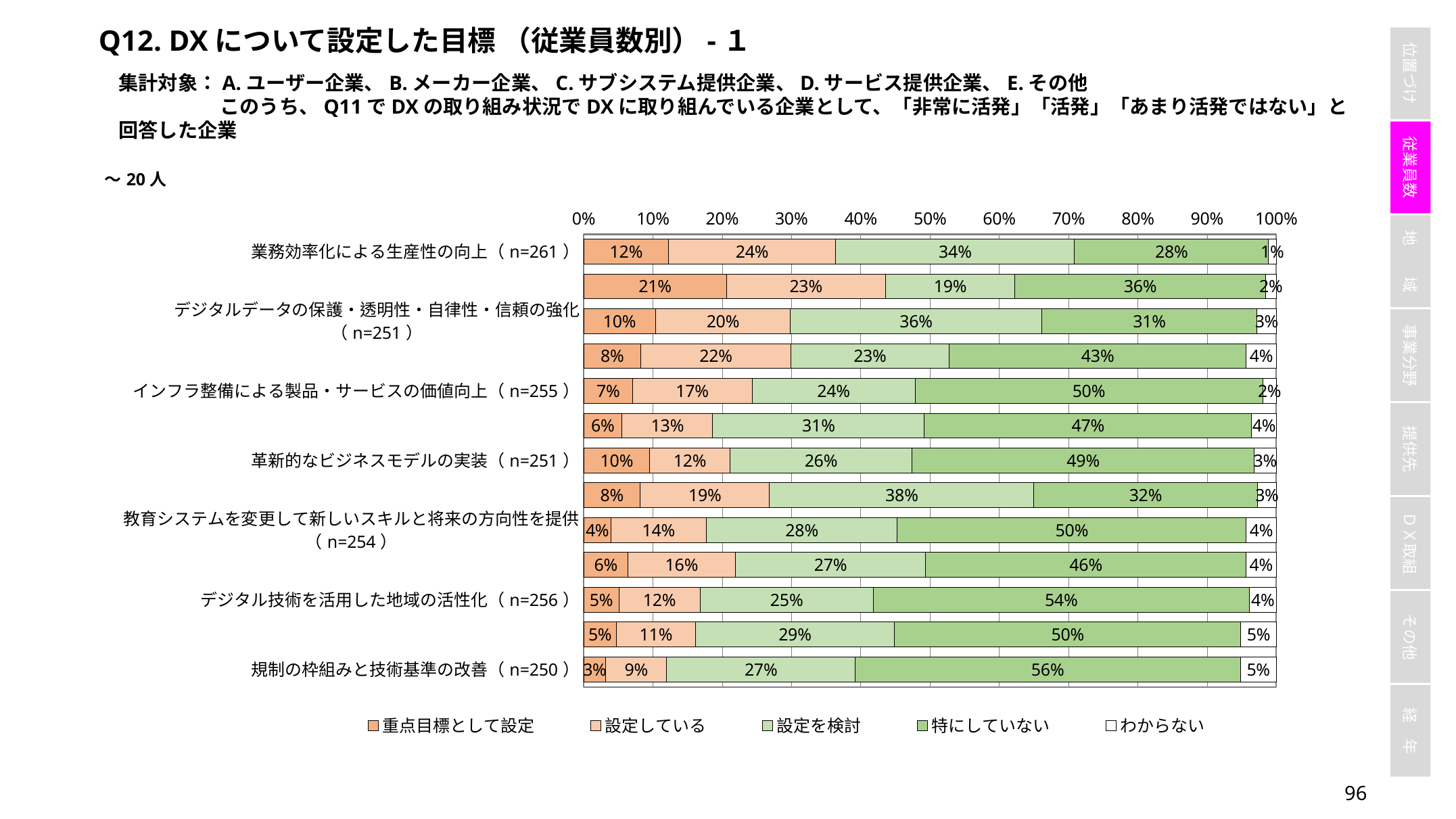
How many series does the legend list? 5 What is the わからない value for デジタル技術を活用した地域の活性化? 4% What is the first entry in the chart legend? 重点目標として設定 Which response category is the largest segment in the bar for 規制の枠組みと技術基準の改善? 特にしていない Which has a larger 特にしていない share: 業務効率化による生産性の向上 or 規制の枠組みと技術基準の改善? 規制の枠組みと技術基準の改善 What is the 設定を検討 value for インフラ整備による製品・サービスの価値向上? 24% What kind of chart is shown on the slide? Stacked bar chart What is the 設定を検討 value for デジタルデータの保護・透明性・自律性・信頼の強化? 36% What percentage of respondents for 業務効率化による生産性の向上 answered 重点目標として設定? 12% What is the 特にしていない value for 規制の枠組みと技術基準の改善? 56% What is the 設定している value for 教育システムを変更して新しいスキルと将来の方向性を提供? 14% What is the difference in the 設定を検討 value between 業務効率化による生産性の向上 and 革新的なビジネスモデルの実装? 8 percentage points